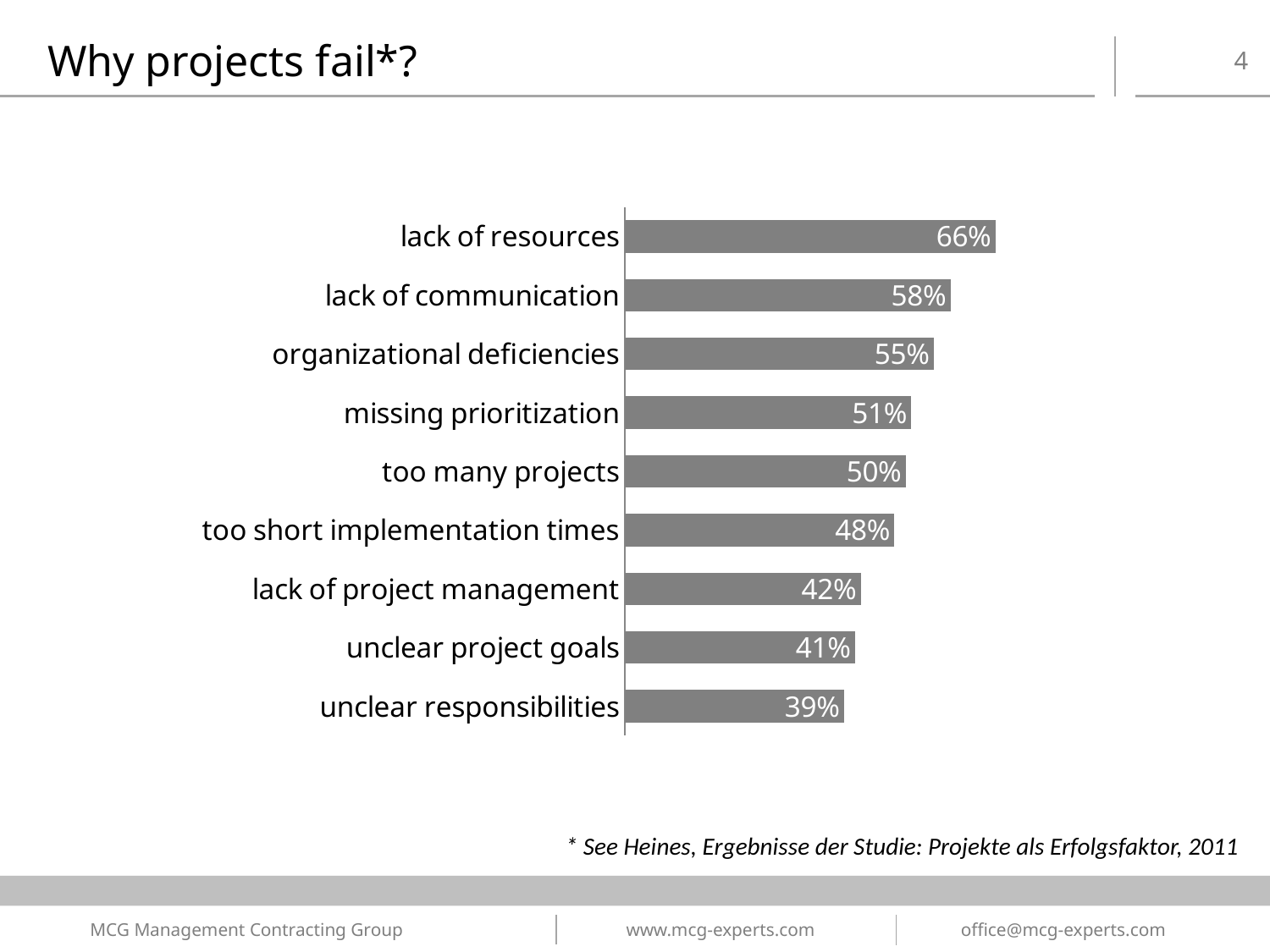
Which category has the highest value? lack of resources Which is larger, organizational deficiencies or too many projects? organizational deficiencies What is the value for missing prioritization? 51% What is the value for too short implementation times? 48% How many categories are shown in the chart? 9 What is the difference between lack of resources and unclear responsibilities? 27% What is the value for lack of resources? 66% What is the difference between lack of communication and lack of project management? 16% What kind of chart is shown on the slide? bar chart What is the value for unclear project goals? 41% What is the title of the slide containing the chart? Why projects fail*? Which category has the lowest value? unclear responsibilities